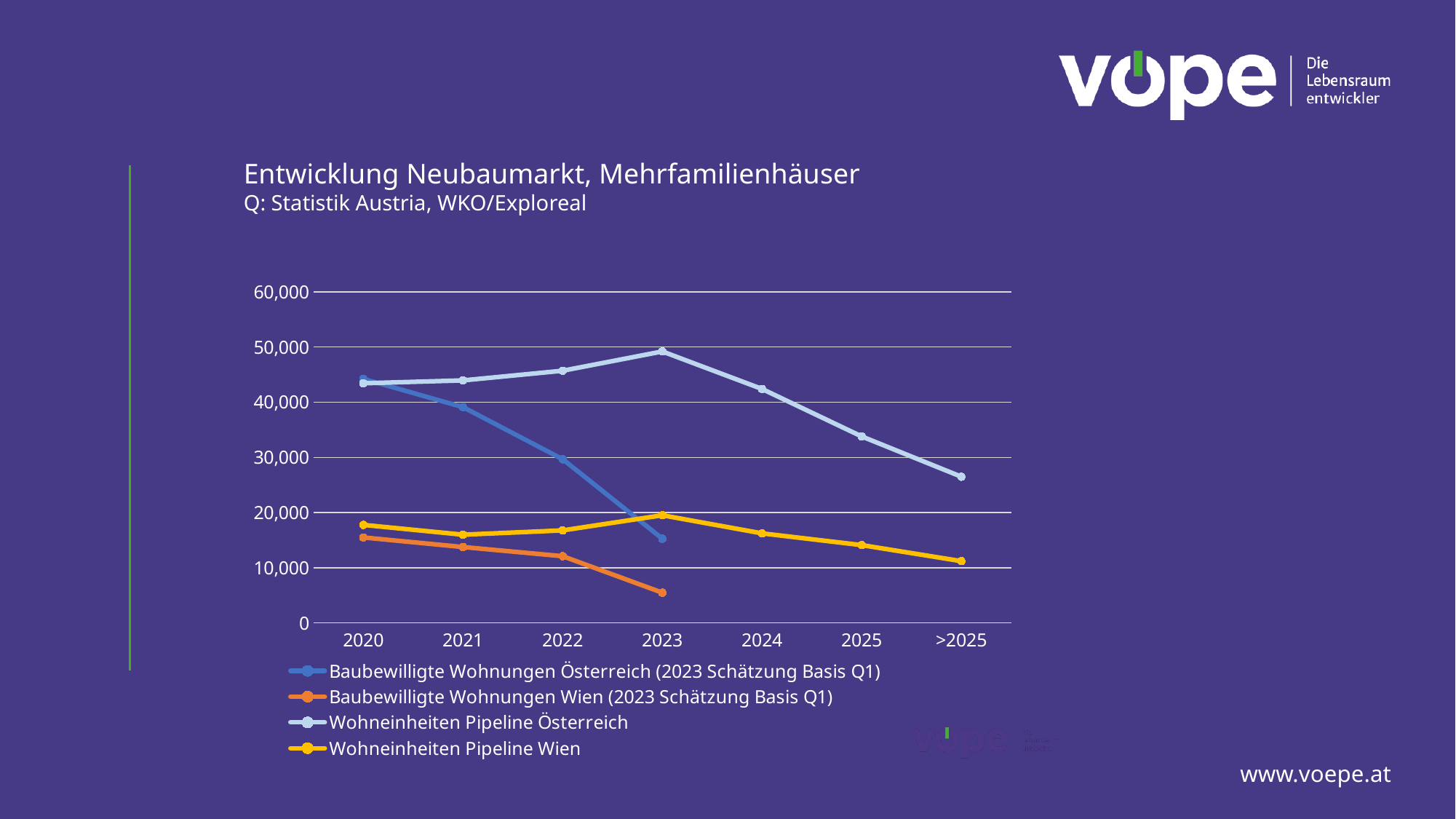
What is the title of the chart? Entwicklung Neubaumarkt, Mehrfamilienhäuser What kind of chart is shown on the slide? line chart How many series does the legend list? 4 Is the value for Baubewilligte Wohnungen Wien in 2023 greater or less than 10,000? less In 2022, which is larger: Baubewilligte Wohnungen Österreich or Wohneinheiten Pipeline Österreich? Wohneinheiten Pipeline Österreich Is the value for Baubewilligte Wohnungen Österreich in 2023 greater or less than 20,000? less In which year does Wohneinheiten Pipeline Österreich reach its highest value? 2023 At which x-axis category is Wohneinheiten Pipeline Wien lowest? >2025 Is the value for Wohneinheiten Pipeline Österreich at >2025 greater or less than 30,000? less Do the values for Baubewilligte Wohnungen Österreich rise or fall from 2020 to 2023? fall How many categories are shown on the x axis? 7